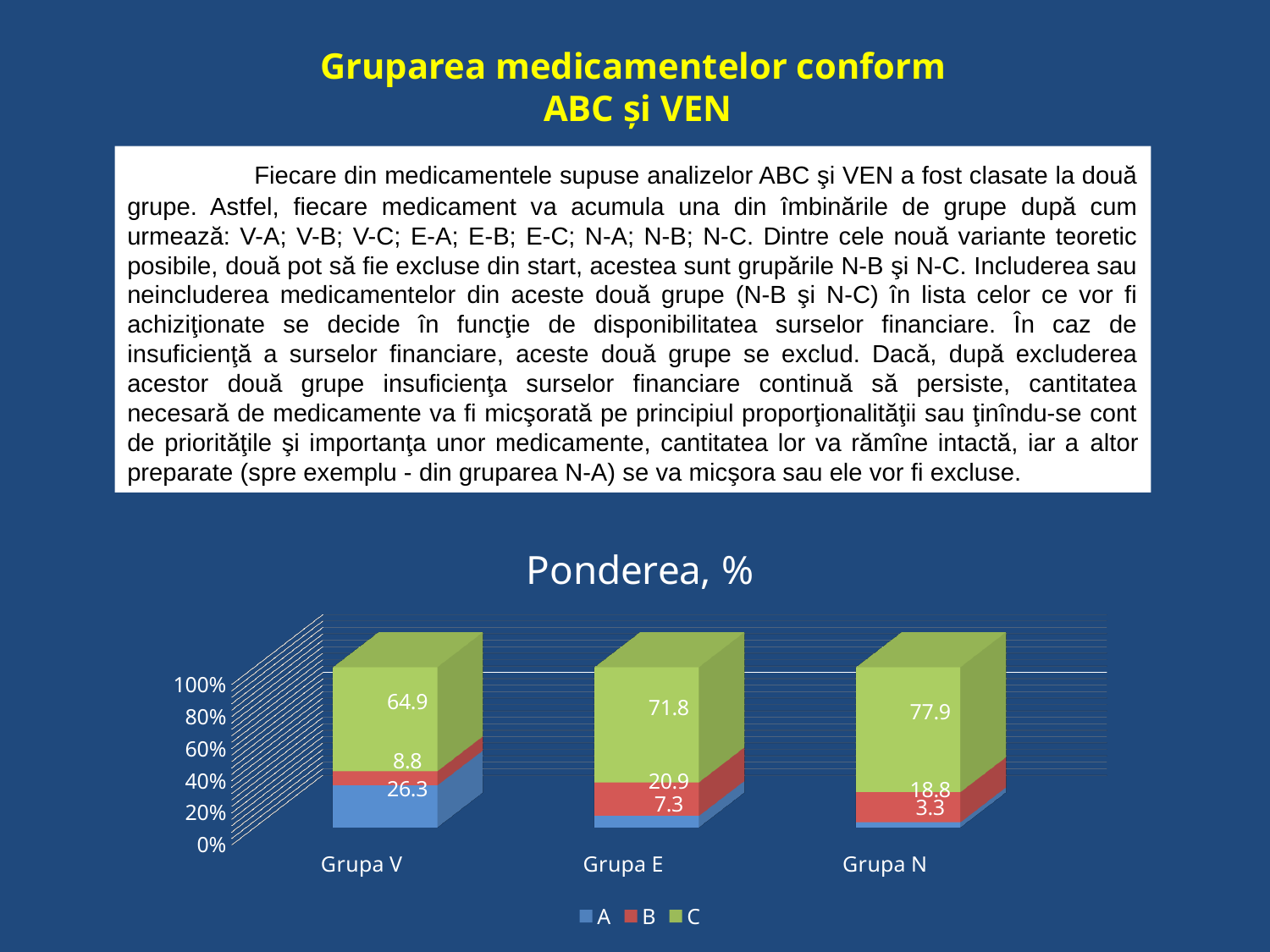
Which category has the lowest value for series A? Grupa N Which is larger: series B for Grupa E or series B for Grupa V? Grupa E What is the title of the chart? Ponderea, % Which category has the highest value for series C? Grupa N Does the value of series A rise or fall from Grupa V to Grupa N? fall What is the value of series A for Grupa E? 7.3 What is the difference between the series C values for Grupa N and Grupa V? 13 How many categories are shown on the x axis? 3 What type of chart is shown under the title "Ponderea, %"? stacked bar chart How many series does the legend list? 3 What is the value of series B for Grupa N? 18.8 What is the value of series C for Grupa V? 64.9